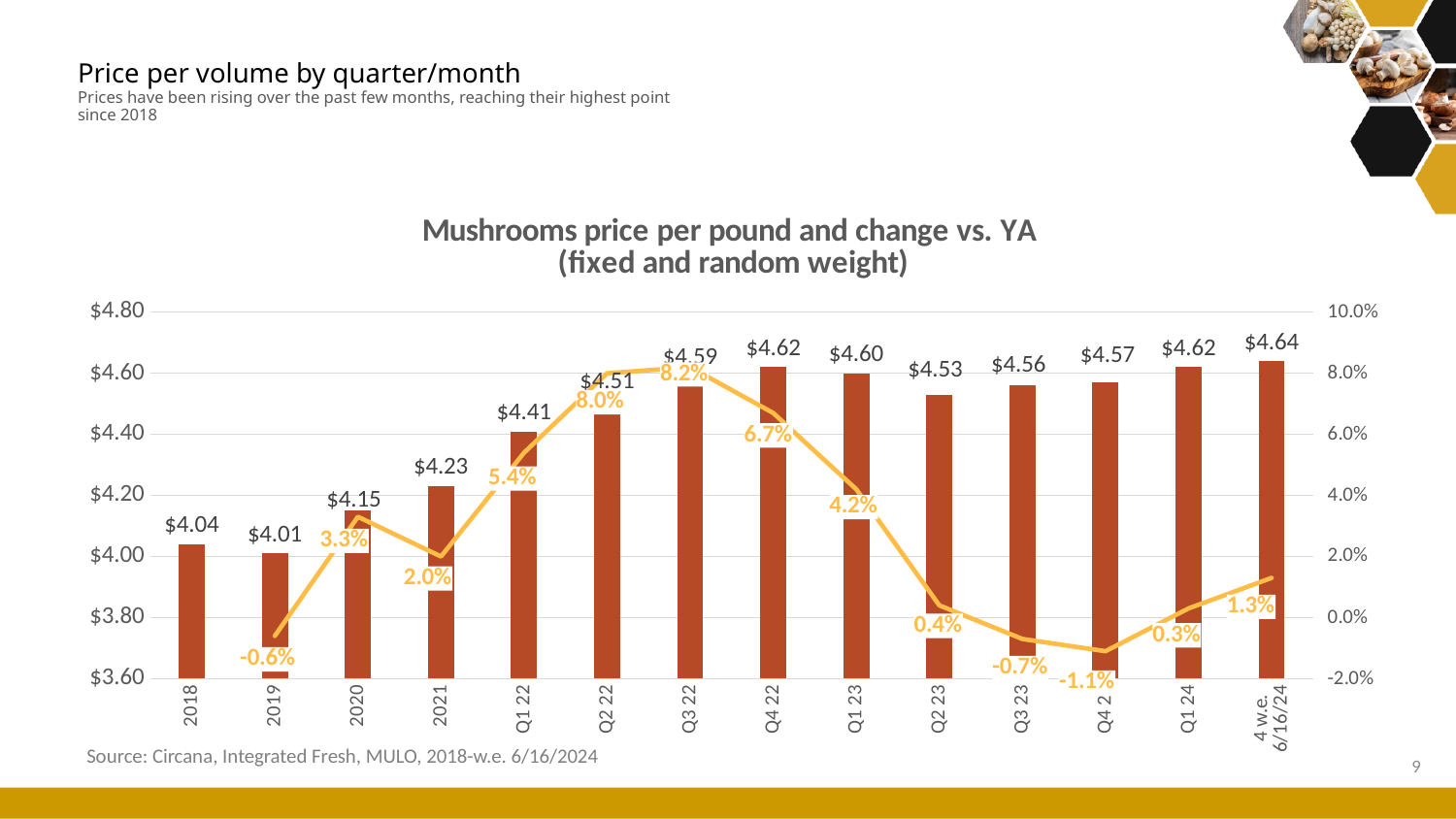
Which period has the highest change vs. YA? Q3 22 What is the change vs. YA shown for Q3 22? 8.2% Does the price per pound rise or fall from Q2 23 to 4 w.e. 6/16/24? Rise Which has the higher price per pound, Q4 22 or Q1 23? Q4 22 What is the change vs. YA shown for 2019? -0.6% What is the title of the chart? Mushrooms price per pound and change vs. YA (fixed and random weight) Which period has the lowest price per pound? 2019 What is the mushroom price per pound for Q1 22? $4.41 How many periods are shown on the x axis? 14 What kind of chart is this? Bar chart with a line overlay Which period has the highest price per pound? 4 w.e. 6/16/24 What is the difference between the price per pound for 4 w.e. 6/16/24 and for 2018? $0.60